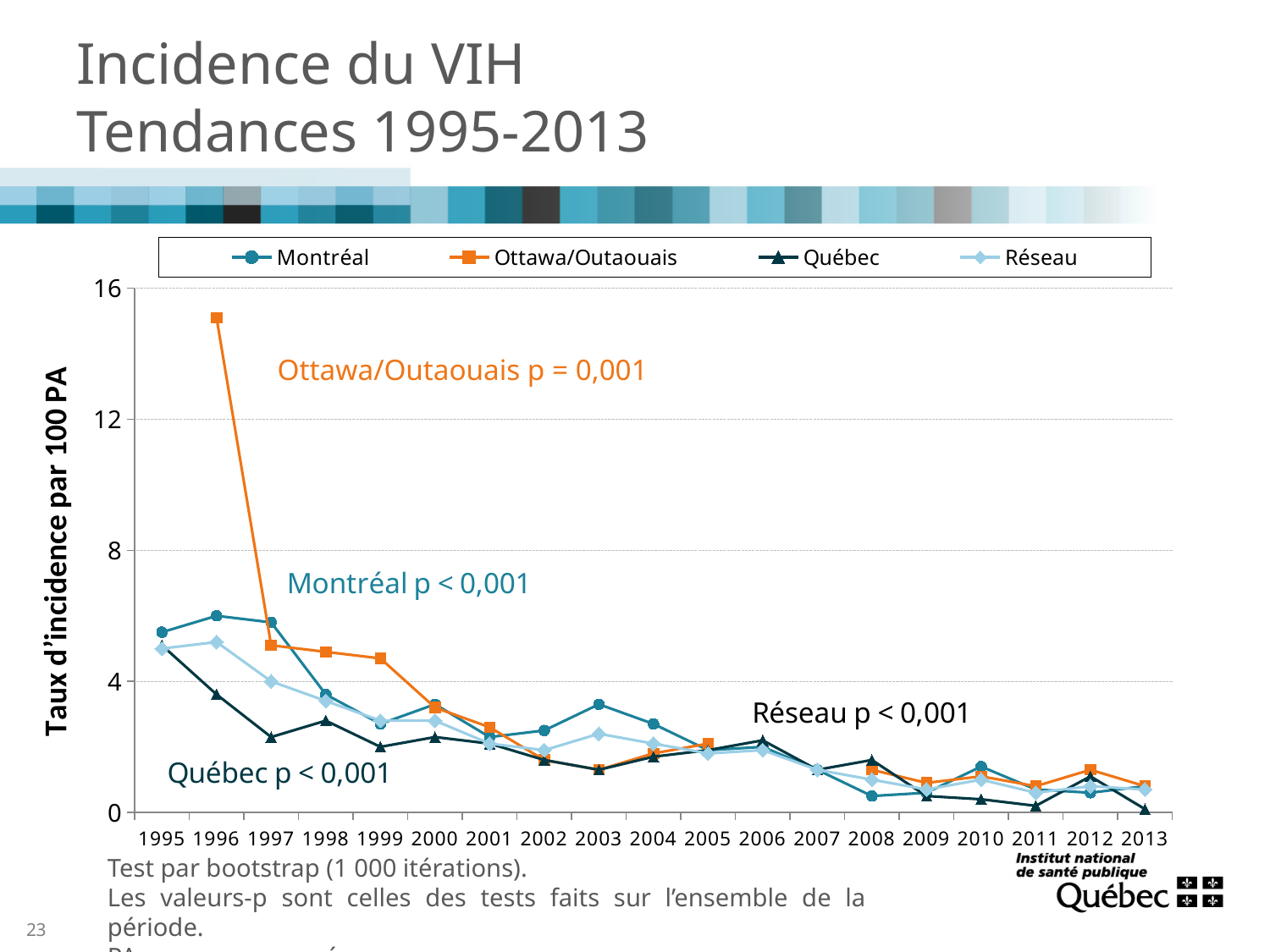
Is the value for Montréal in 1996 greater or less than 4? greater Is the value for Ottawa/Outaouais in 1996 greater or less than 12? greater What is the label of the y axis? Taux d'incidence par 100 PA Is the value for Québec in 2013 greater or less than 4? less Which series has the highest value in 1996? Ottawa/Outaouais How many years are shown along the x axis? 19 What kind of chart is shown on the slide? line chart In 1997, which is larger: the value for Montréal or the value for Québec? Montréal What p-value is annotated on the chart for Ottawa/Outaouais? p = 0,001 Does the Québec series generally rise or fall from 1995 to 2013? fall How many series does the legend list? 4